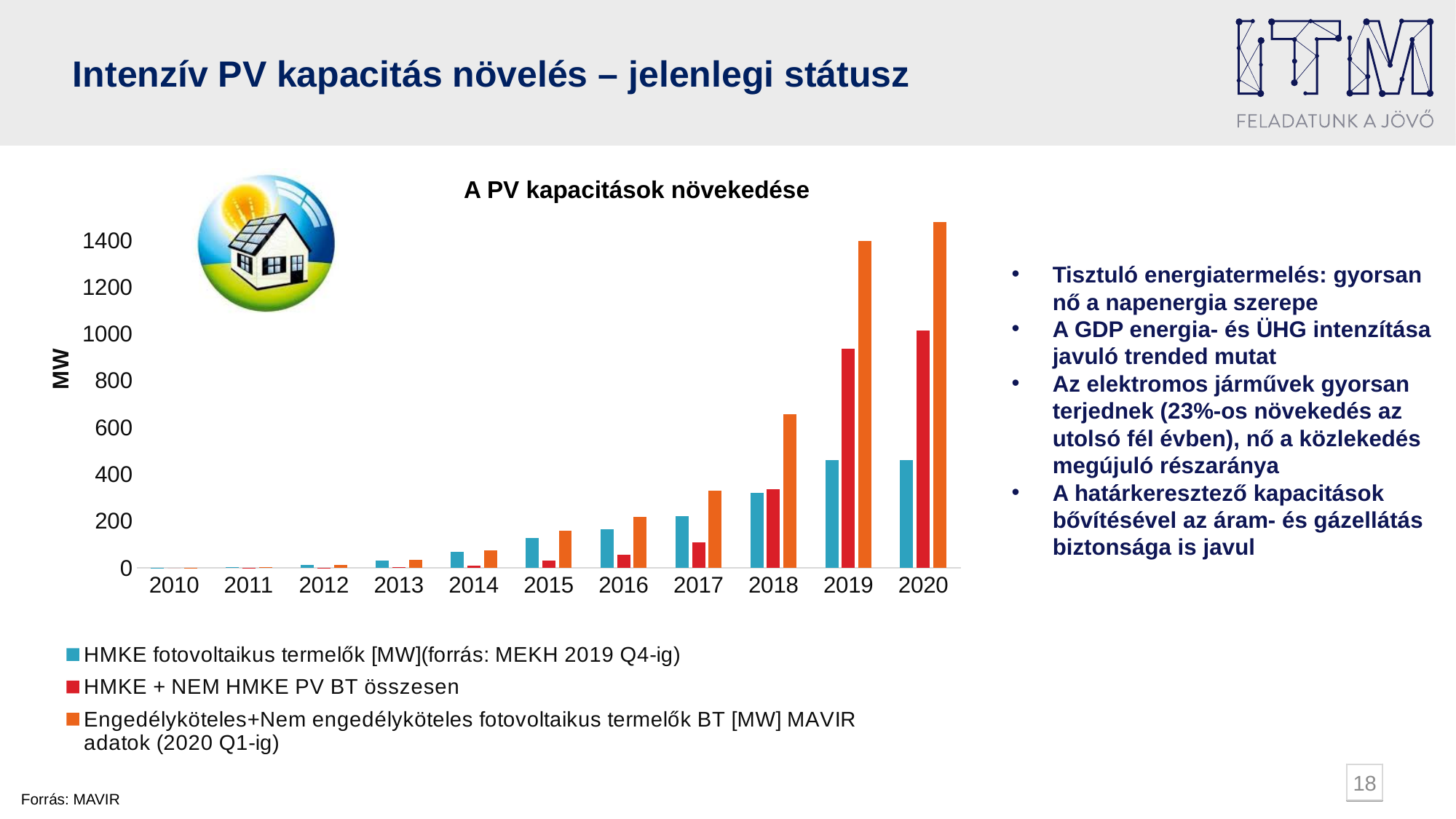
Is the value for the 'HMKE + NEM HMKE PV BT összesen' series in 2019 greater or less than 1000? less In which year is the 'Engedélyköteles+Nem engedélyköteles fotovoltaikus termelők BT [MW] MAVIR adatok (2020 Q1-ig)' series highest? 2020 Do the values of the 'Engedélyköteles+Nem engedélyköteles fotovoltaikus termelők BT [MW] MAVIR adatok (2020 Q1-ig)' series rise or fall from 2010 to 2020? rise In 2019, which is larger: the 'HMKE + NEM HMKE PV BT összesen' value or the 'Engedélyköteles+Nem engedélyköteles fotovoltaikus termelők BT [MW] MAVIR adatok (2020 Q1-ig)' value? Engedélyköteles+Nem engedélyköteles fotovoltaikus termelők BT [MW] MAVIR adatok (2020 Q1-ig) How many series does the chart's legend list? 3 Is the value for the 'Engedélyköteles+Nem engedélyköteles fotovoltaikus termelők BT [MW] MAVIR adatok (2020 Q1-ig)' series in 2017 greater or less than 400? less Is the value for the 'HMKE fotovoltaikus termelők [MW](forrás: MEKH 2019 Q4-ig)' series in 2019 greater or less than 400? greater How many years are shown on the x axis of the chart? 11 What kind of chart is shown on the slide? bar chart What unit is shown on the y axis of the chart? MW What is the title of the chart? A PV kapacitások növekedése